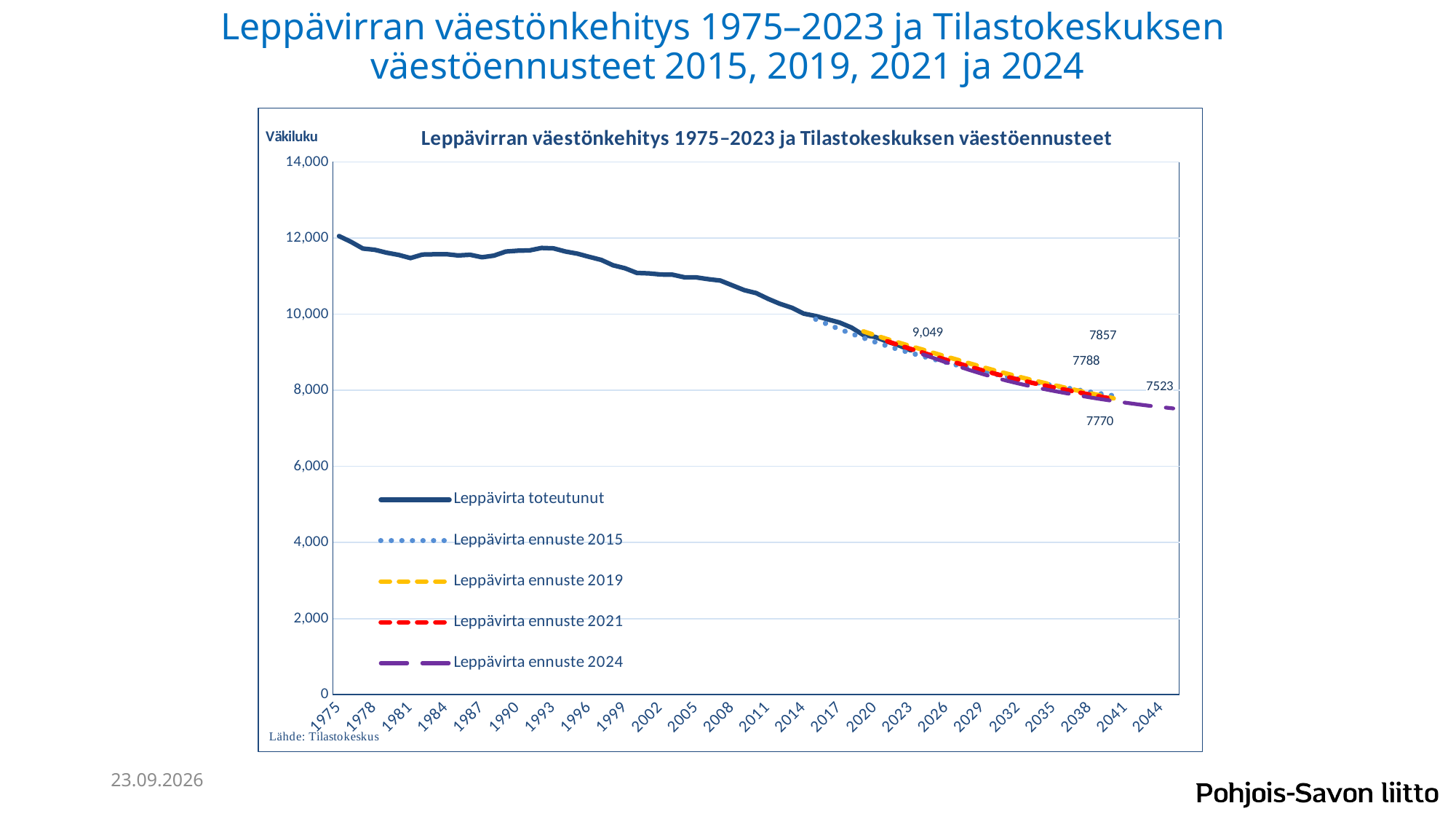
How many series does the chart legend list? 5 What is the difference between the data labels 7788 and 7770? 18 What is the title of the chart? Leppävirran väestönkehitys 1975–2023 ja Tilastokeskuksen väestöennusteet Does the Leppävirta toteutunut series generally rise or fall from 1975 to 2023? Fall Is the value of Leppävirta toteutunut in 1993 greater or less than 11,000? greater What is the difference between the data labels 7857 and 7523? 334 Which legend entry is drawn as a solid dark blue line? Leppävirta toteutunut What is the highest value printed as a data label on the chart? 9,049 What kind of chart is shown on the slide? Line chart Which is larger, the data label 7857 or the data label 7788? 7857 Is the value of Leppävirta toteutunut in 2014 greater or less than 11,000? less What is the lowest value printed as a data label on the chart? 7523